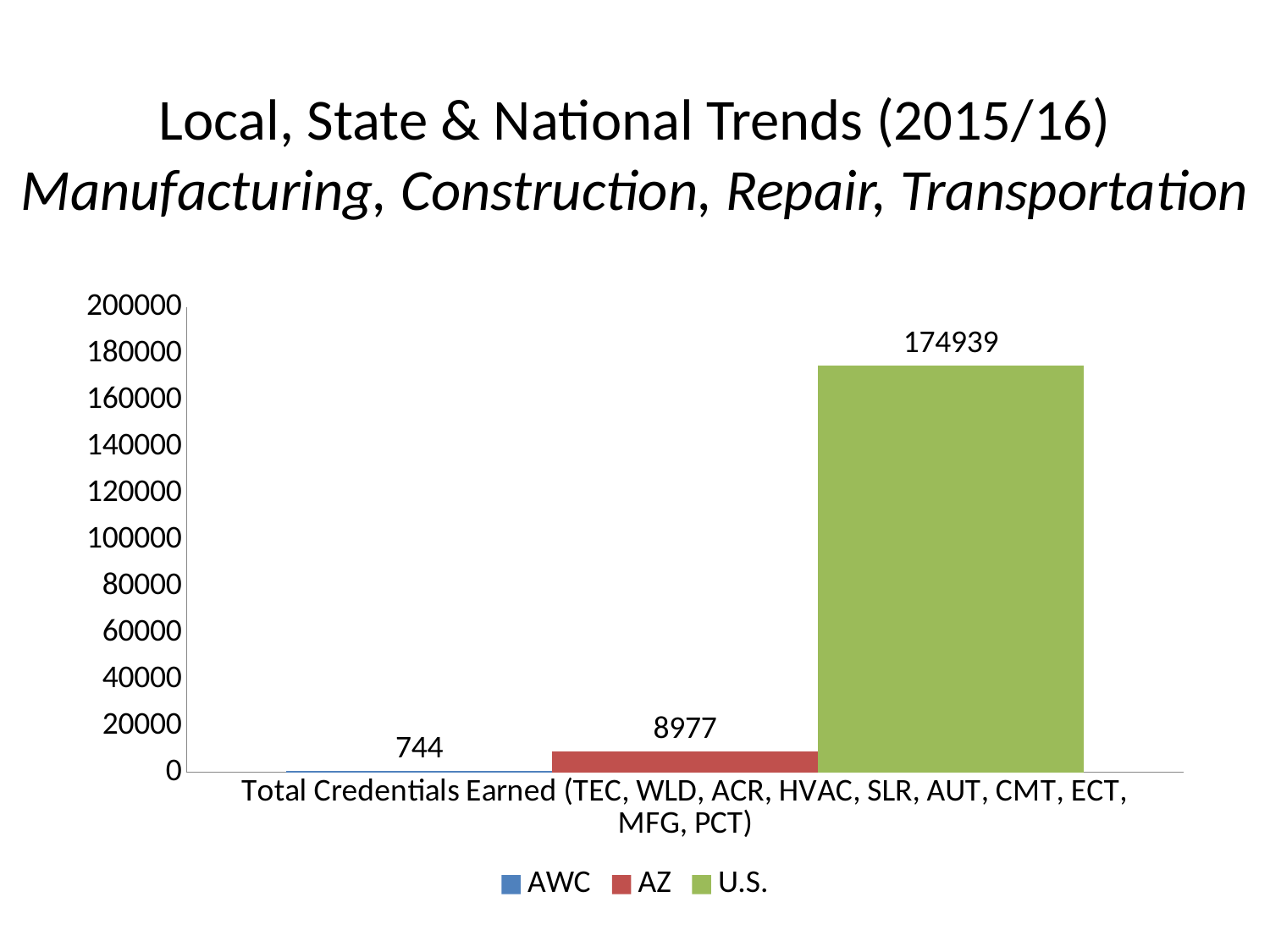
What is the difference between the AZ value and the AWC value? 8233 What is the difference between the U.S. value and the AZ value? 165962 Which series has the lowest value? AWC What kind of chart is shown on the slide? bar chart What is the value for U.S.? 174939 Which is larger, the value for AZ or the value for AWC? AZ What is the value for AWC? 744 How many series does the legend list? 3 Which series has the highest value? U.S. What is the value for AZ? 8977 Is the value for U.S. greater or less than 160000? greater What colour is the bar for U.S.? green